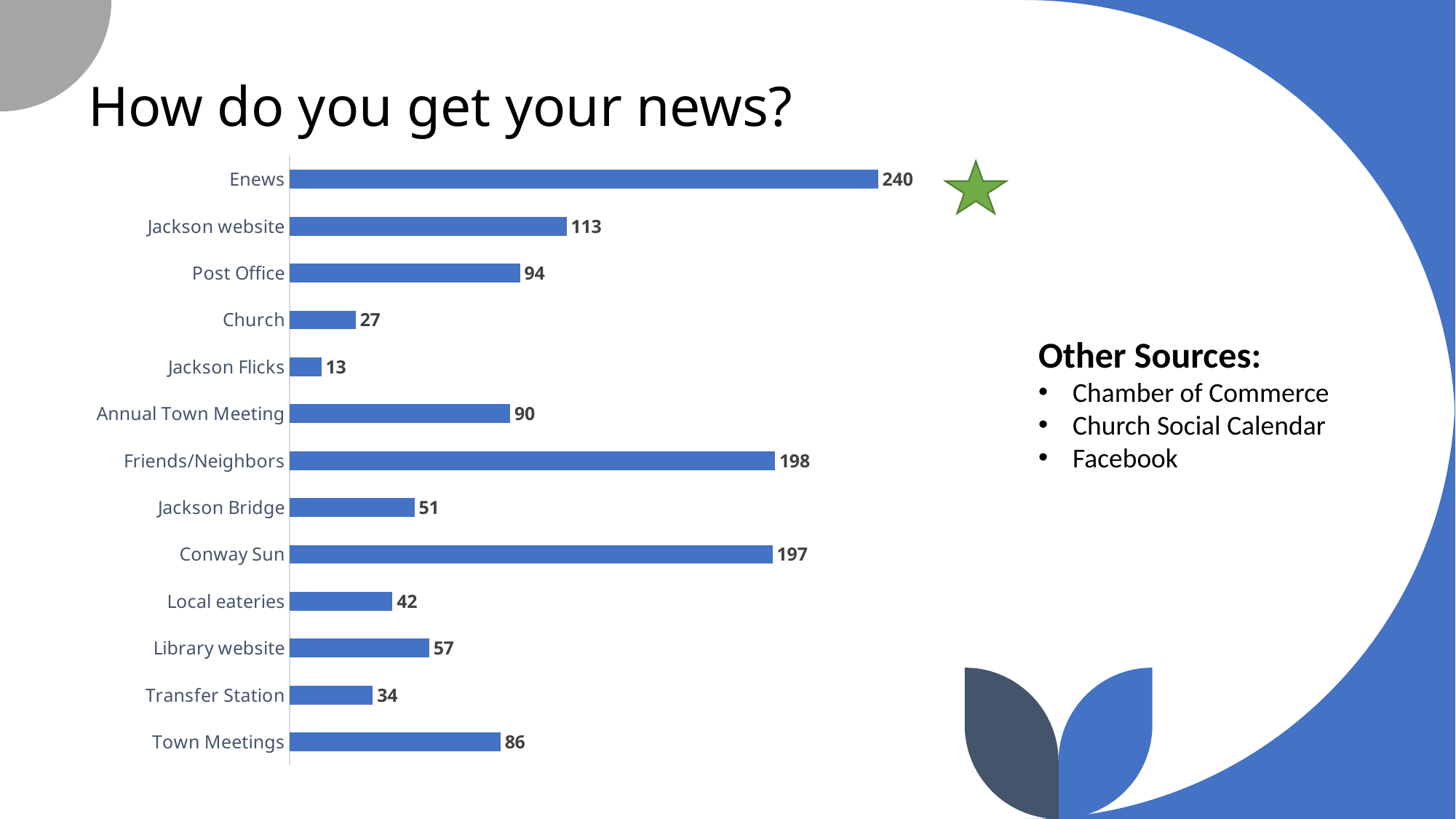
Which is larger, the value for Library website or the value for Jackson Bridge? Library website What is the title of the slide containing the chart? How do you get your news? Which is larger, the value for Town Meetings or the value for Local eateries? Town Meetings What is the difference between the values for Post Office and Annual Town Meeting? 4 What is the value for Jackson Flicks? 13 Which category has the lowest value? Jackson Flicks How many categories are shown in the chart? 13 What is the difference between the values for Enews and Jackson website? 127 Which category has the highest value? Enews What is the value for Conway Sun? 197 What kind of chart is shown on the slide? Bar chart What is the value for Enews? 240